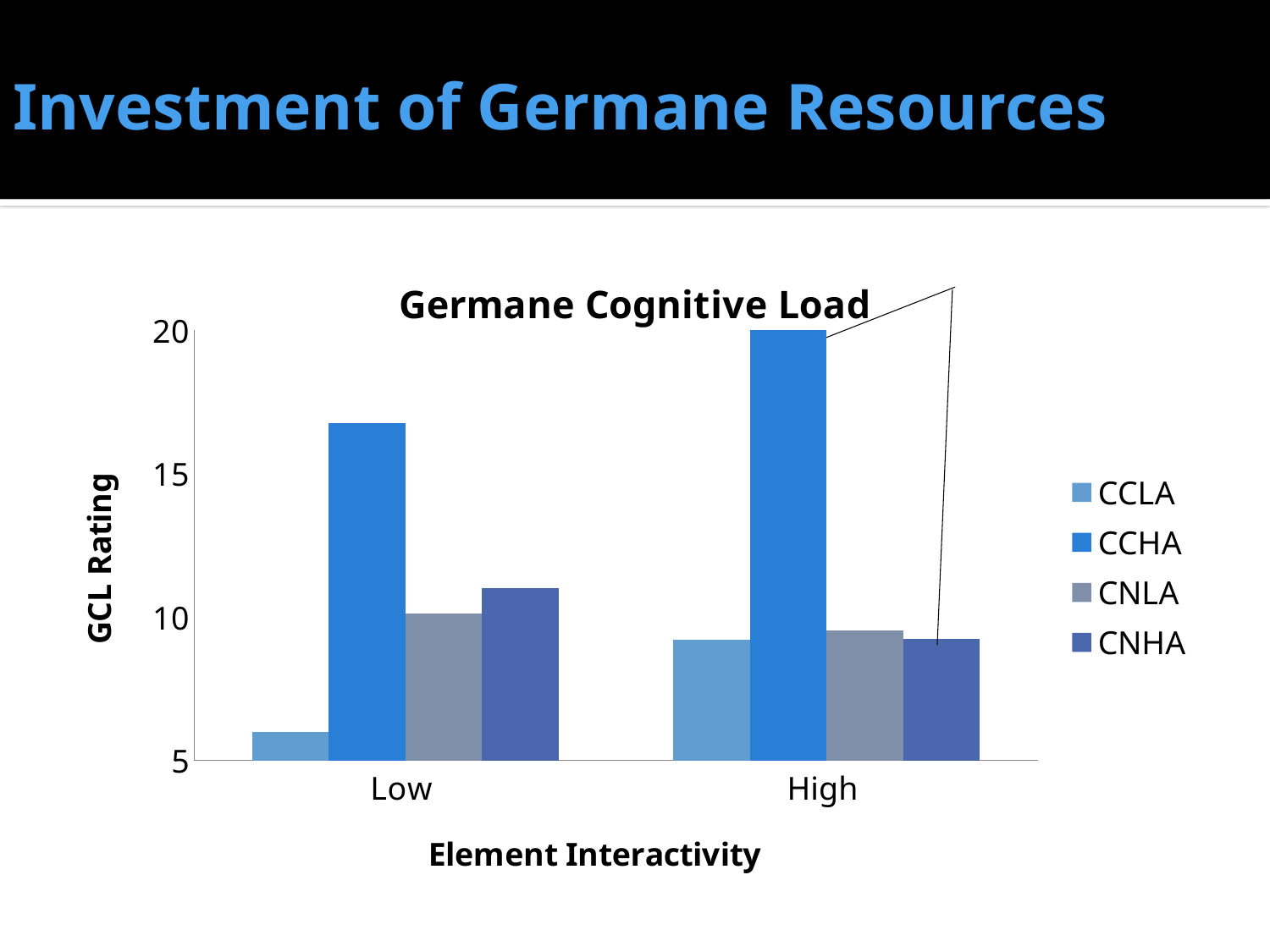
What is the title of the vertical axis of the chart? GCL Rating What kind of chart is shown on the slide? bar chart Does the GCL Rating for CCHA rise or fall from Low to High element interactivity? rise Which series has the highest GCL Rating in the High element interactivity group? CCHA Which series has the highest GCL Rating in the Low element interactivity group? CCHA Which series has the lowest GCL Rating in the Low element interactivity group? CCLA Is the GCL Rating for CCHA at Low element interactivity greater or less than 15? greater For the CNHA series, is the GCL Rating larger at Low or at High element interactivity? Low For the CCLA series, is the GCL Rating larger at Low or at High element interactivity? High How many Element Interactivity categories are shown on the x axis? 2 How many series does the legend of the Germane Cognitive Load chart list? 4 Is the GCL Rating for CCLA at Low element interactivity greater or less than 10? less